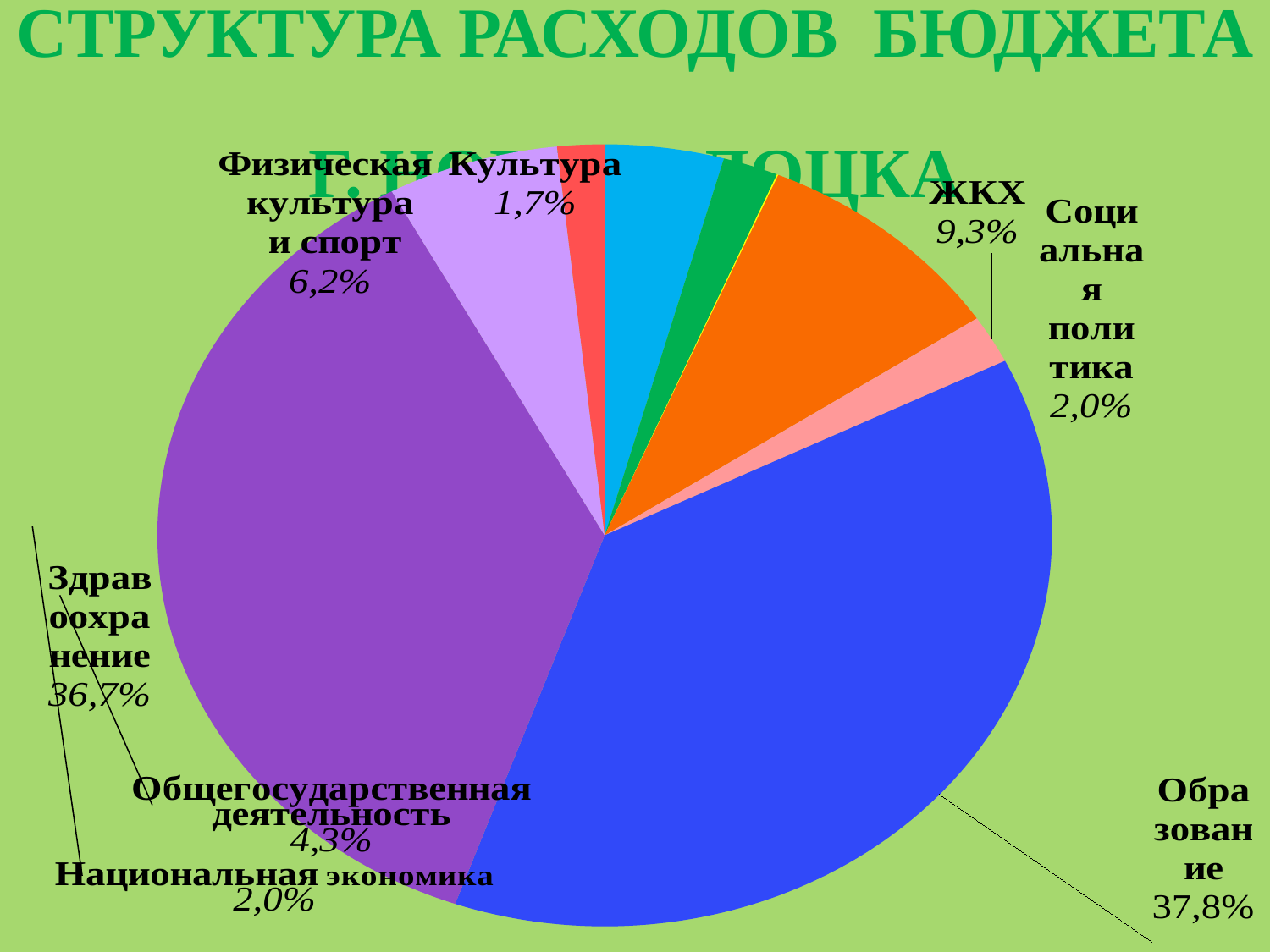
What share of budget expenditure goes to Образование? 37,8% What share of budget expenditure goes to Культура? 1,7% What kind of chart is shown on the slide? pie chart What share of budget expenditure goes to Здравоохранение? 36,7% By how many percentage points does Образование exceed Здравоохранение? 1,1 What share of budget expenditure goes to Физическая культура и спорт? 6,2% Which is larger: the share for ЖКХ or the share for Физическая культура и спорт? ЖКХ Which category has the largest share of the pie? Образование What share of budget expenditure goes to ЖКХ? 9,3% What share of budget expenditure goes to Общегосударственная деятельность? 4,3%